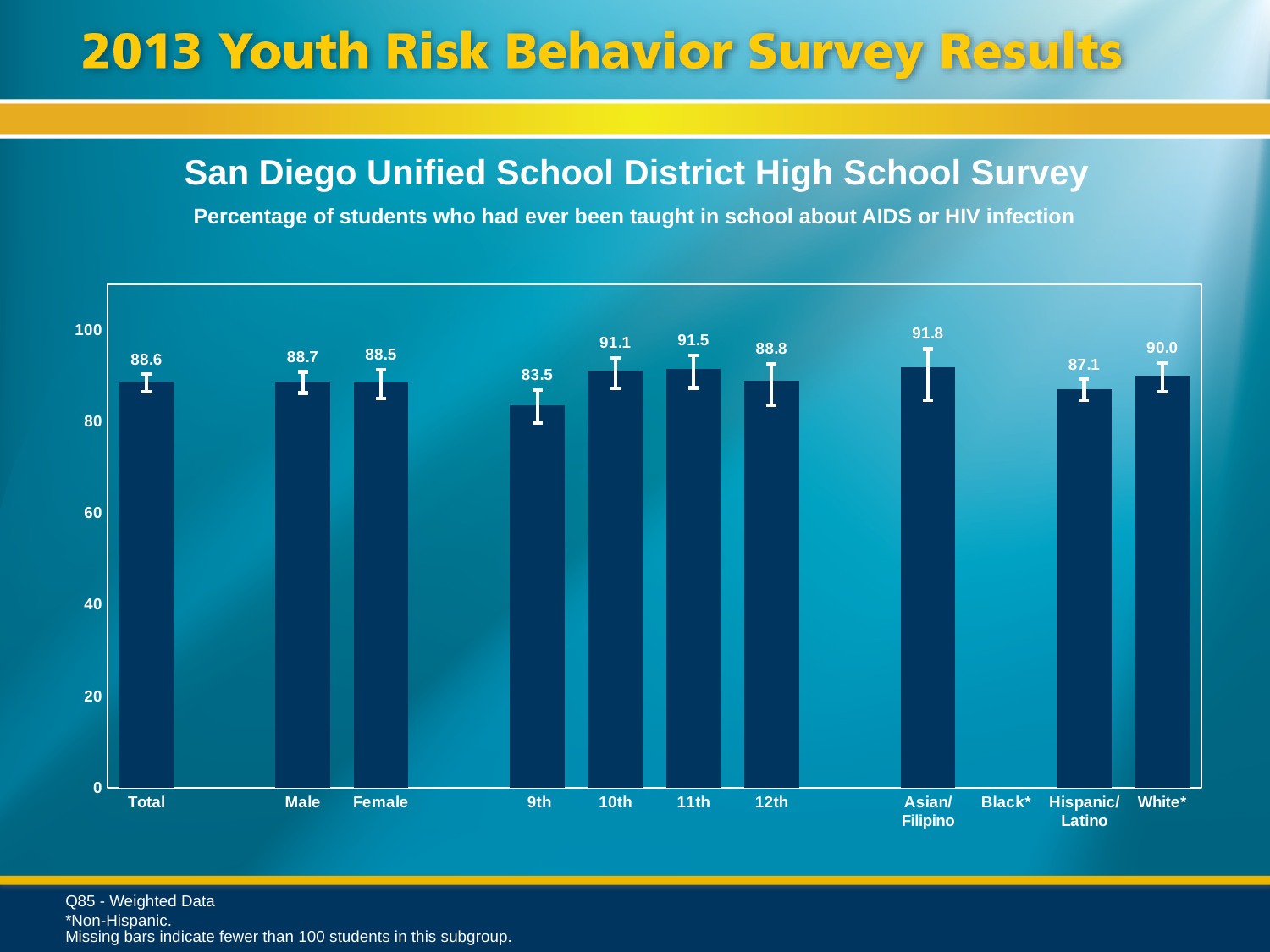
What is the value for 9th grade? 83.5 How many bars are plotted on the chart? 11 Which category has the highest value? Asian/Filipino What is the value for Asian/Filipino? 91.8 Is the value for White* greater or less than 80? greater What is the value for Total? 88.6 Which is larger, the value for 10th or the value for 12th? 10th What kind of chart is shown? bar chart What is the difference between the values for 11th and 9th? 8.0 Which category has the lowest value? 9th What is the value for Hispanic/Latino? 87.1 Which category label has no bar plotted? Black*